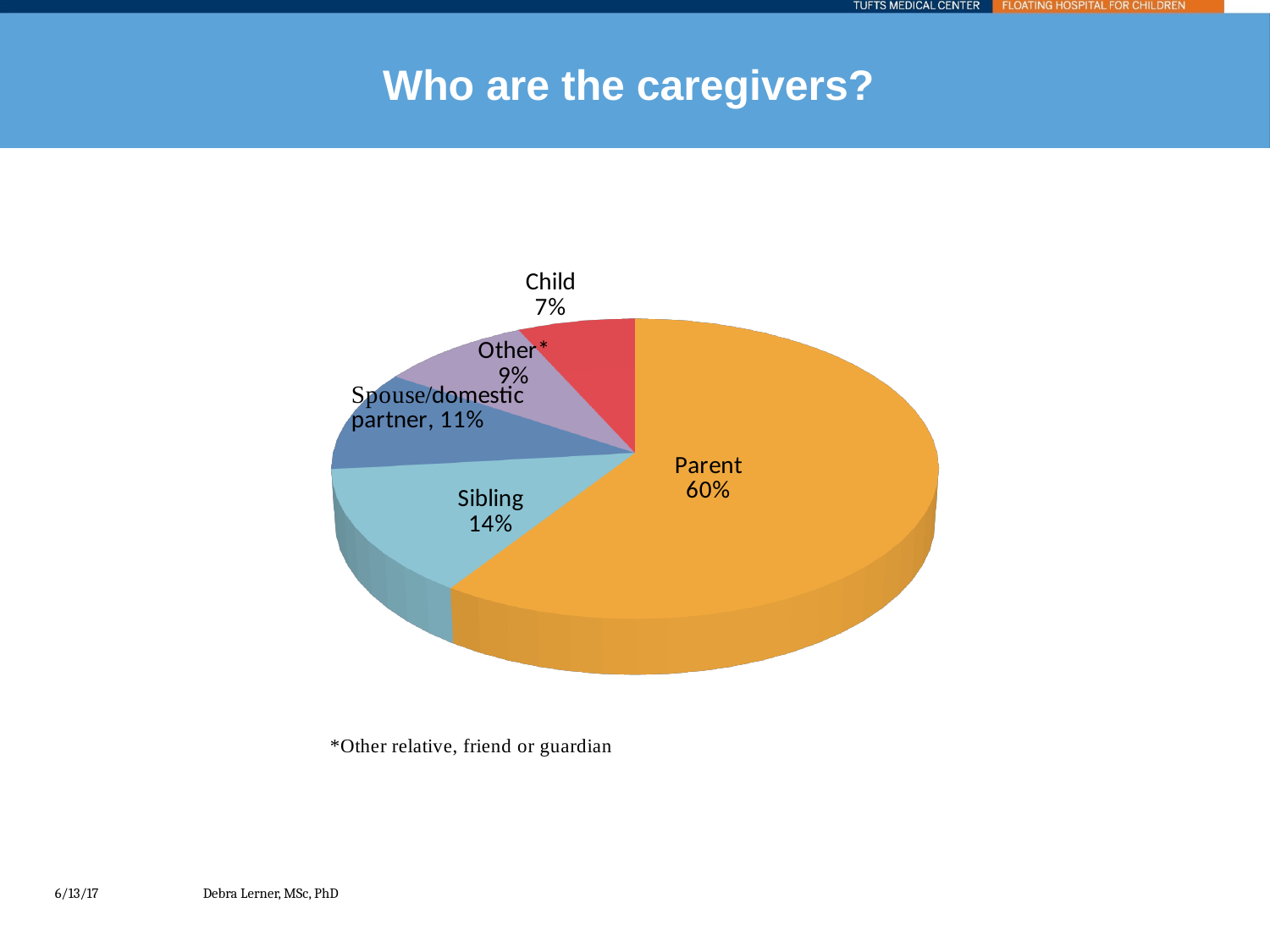
What is the difference in percentage points between the Parent and Sibling slices? 46 What percentage of caregivers fall into the Other category? 9% What percentage of caregivers are siblings? 14% Which is larger, the Sibling slice or the Spouse/domestic partner slice? Sibling What kind of chart is shown on the slide? Pie chart How many categories are shown in the pie chart? 5 Which caregiver category has the largest share of the pie? Parent Which caregiver category has the smallest share of the pie? Child What percentage of caregivers are a spouse/domestic partner? 11% What percentage of caregivers are children? 7% What percentage of caregivers are parents? 60% What is the title of the chart slide? Who are the caregivers?